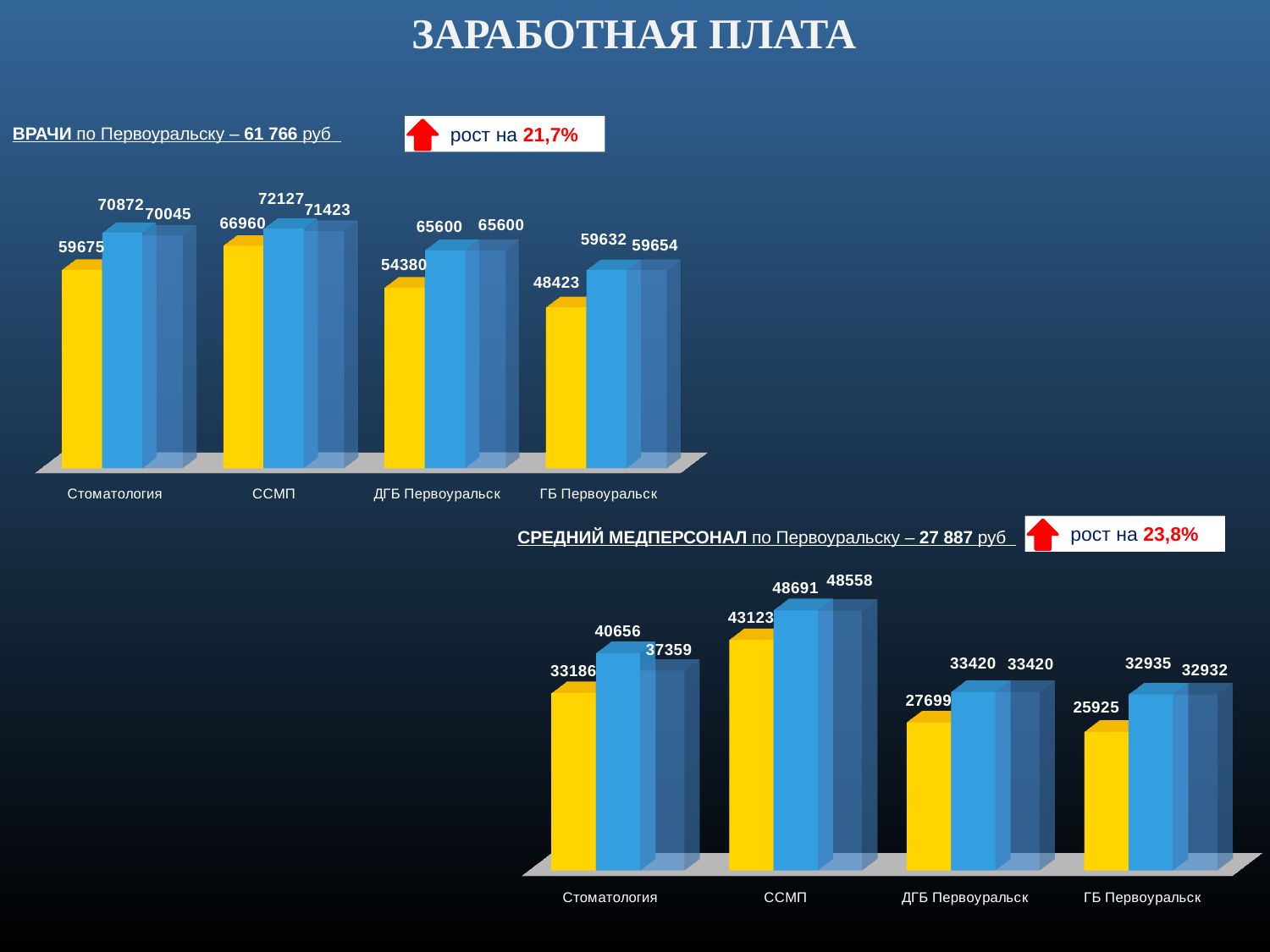
In the top chart (ВРАЧИ), what is the value of the light blue (second) bar for ССМП? 72127 In the bottom chart (СРЕДНИЙ МЕДПЕРСОНАЛ), what is the difference between the light blue (second) bar and the yellow (first) bar for ДГБ Первоуральск? 5721 In the bottom chart (СРЕДНИЙ МЕДПЕРСОНАЛ), what is the value of the yellow (first) bar for ГБ Первоуральск? 25925 In the bottom chart (СРЕДНИЙ МЕДПЕРСОНАЛ), which category has the highest light blue (second) bar? ССМП In the top chart (ВРАЧИ), how many categories are shown on the x axis? 4 What kind of chart is used for the ВРАЧИ data at the top of the slide? Bar chart In the top chart (ВРАЧИ), what is the value of the yellow (first) bar for Стоматология? 59675 In the bottom chart (СРЕДНИЙ МЕДПЕРСОНАЛ), what is the value of the dark blue (third) bar for Стоматология? 37359 In the bottom chart (СРЕДНИЙ МЕДПЕРСОНАЛ), which is larger: the yellow bar for ССМП or the yellow bar for Стоматология? ССМП How many bars are shown per category in the bottom chart (СРЕДНИЙ МЕДПЕРСОНАЛ)? 3 In the top chart (ВРАЧИ), which category has the lowest yellow (first) bar? ГБ Первоуральск In the top chart (ВРАЧИ), what is the difference between the light blue (second) bar and the yellow (first) bar for ДГБ Первоуральск? 11220